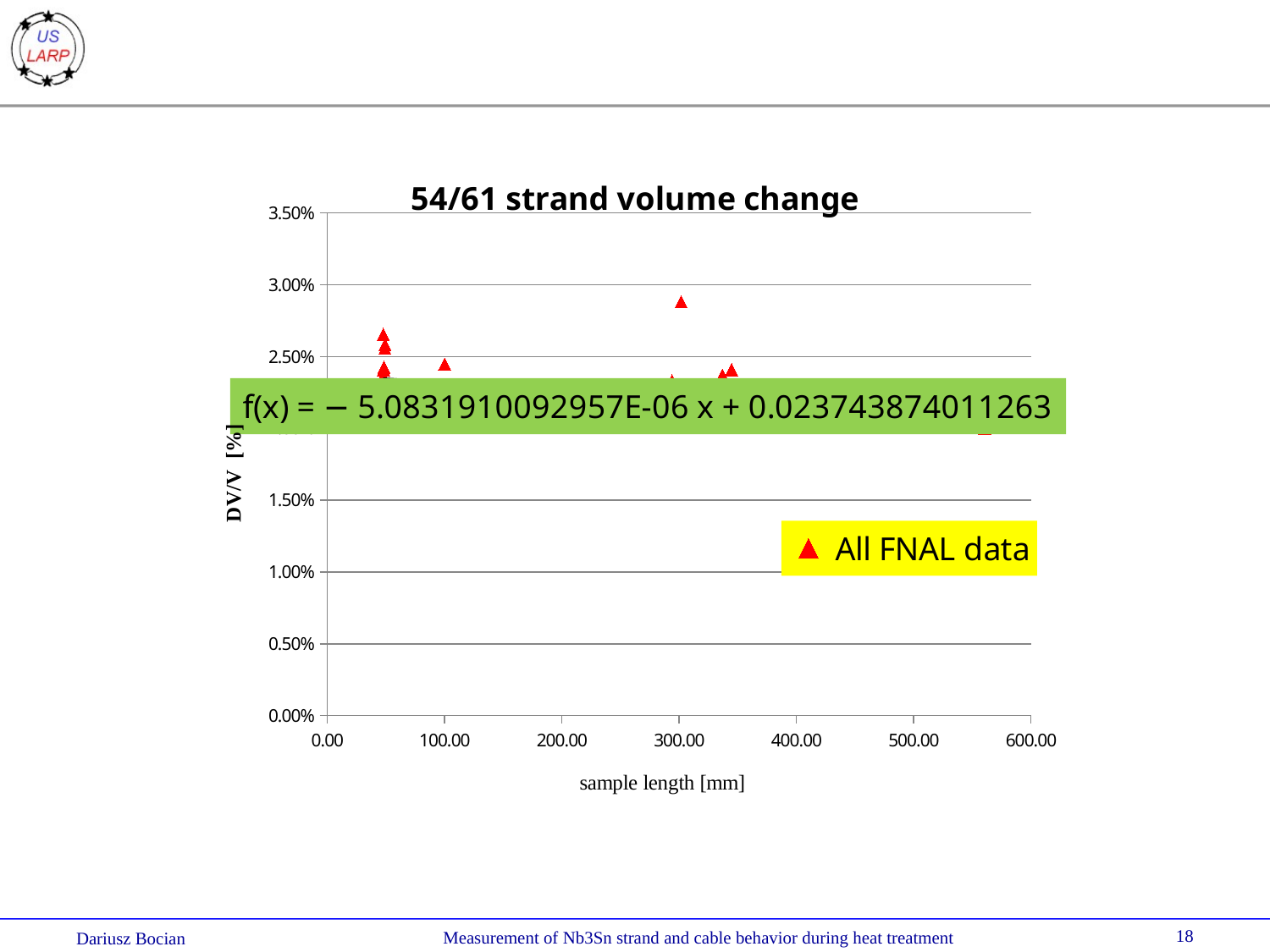
What is the title of the chart? 54/61 strand volume change Is the highest plotted point (near a sample length of 300 mm) greater or less than 2.50%? greater What is the name of the series shown in the legend? All FNAL data Are the points plotted near a sample length of 50 mm greater or less than 2.00%? greater How many series does the chart legend list? 1 According to the fitted line equation shown, do the values rise or fall as sample length increases? fall Is the point plotted near a sample length of 100 mm greater or less than 2.00%? greater What is the highest value shown on the y axis? 3.50% What is the highest value shown on the x axis? 600.00 What kind of chart is shown on the slide? scatter chart What is the label of the x axis? sample length [mm]